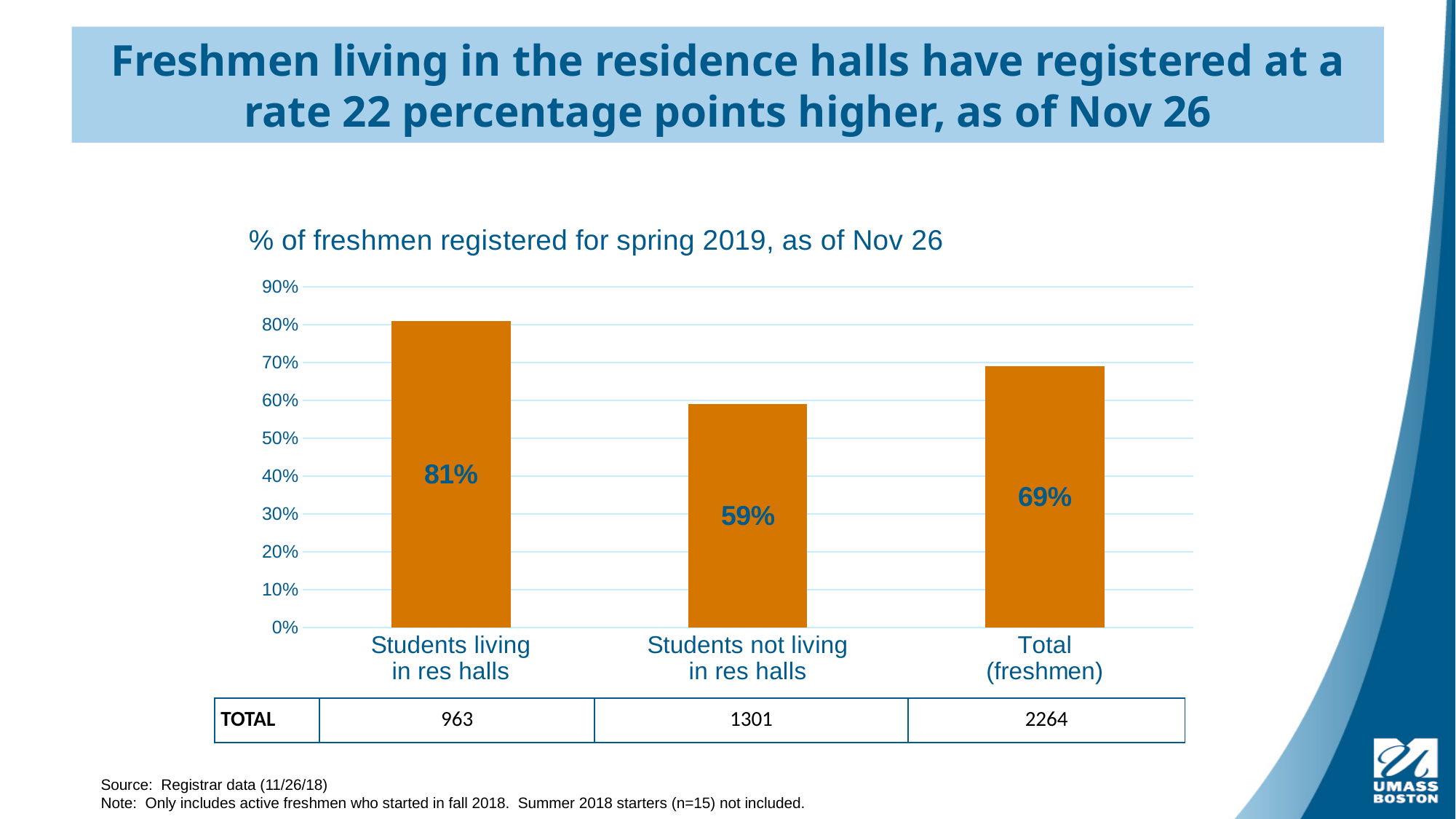
What percentage of students not living in res halls had registered for spring 2019? 59% What is the title of the chart? % of freshmen registered for spring 2019, as of Nov 26 What is the TOTAL number of students not living in res halls shown in the table below the chart? 1301 Is the registration rate for students not living in res halls greater or less than 60%? less Which category has the highest registration rate? Students living in res halls What percentage of students living in res halls had registered for spring 2019 as of Nov 26? 81% How many categories are shown on the chart? 3 What is the registration rate for Total (freshmen)? 69% Which category has the lowest registration rate? Students not living in res halls Which is larger: the registration rate for Total (freshmen) or for students not living in res halls? Total (freshmen) How many percentage points higher is the registration rate for students living in res halls than for students not living in res halls? 22 What kind of chart is shown on the slide? bar chart